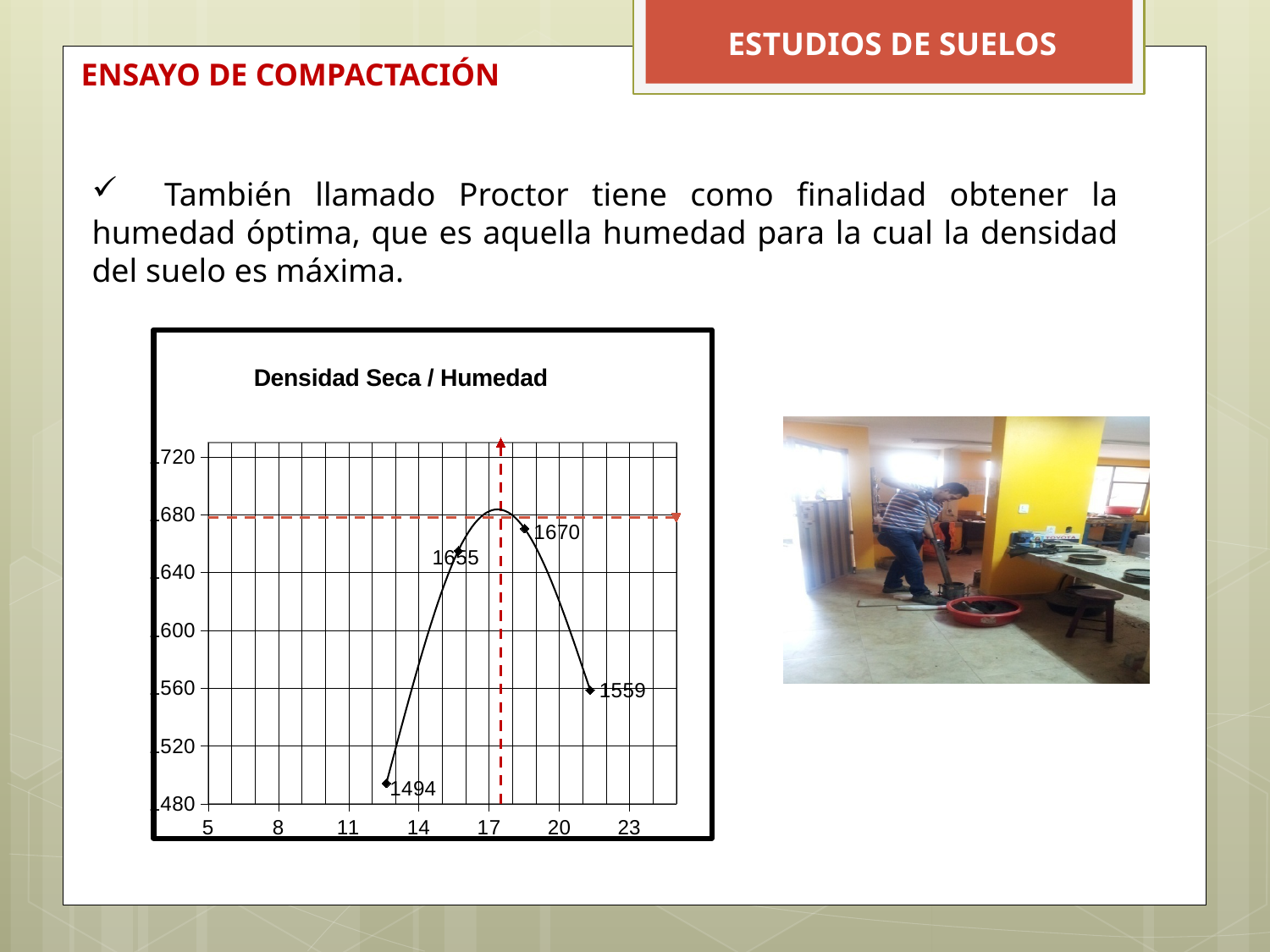
How many data points are plotted on the chart? 4 What is the title of the chart? Densidad Seca / Humedad What is the data label on the rightmost point of the curve? 1559 What is the difference between the values 1670 and 1655? 15 What is the data label on the leftmost point of the curve? 1494 What is the lowest labelled value on the chart? 1494 What kind of chart is shown on the slide? line chart What is the highest labelled value on the chart? 1670 Is the value of the rightmost point (1559) greater or less than 1600? less Which is larger, the value 1655 or the value 1559? 1655 Do the plotted values rise or fall along the x axis? rise then fall What is the difference between the highest labelled value (1670) and the lowest labelled value (1494)? 176